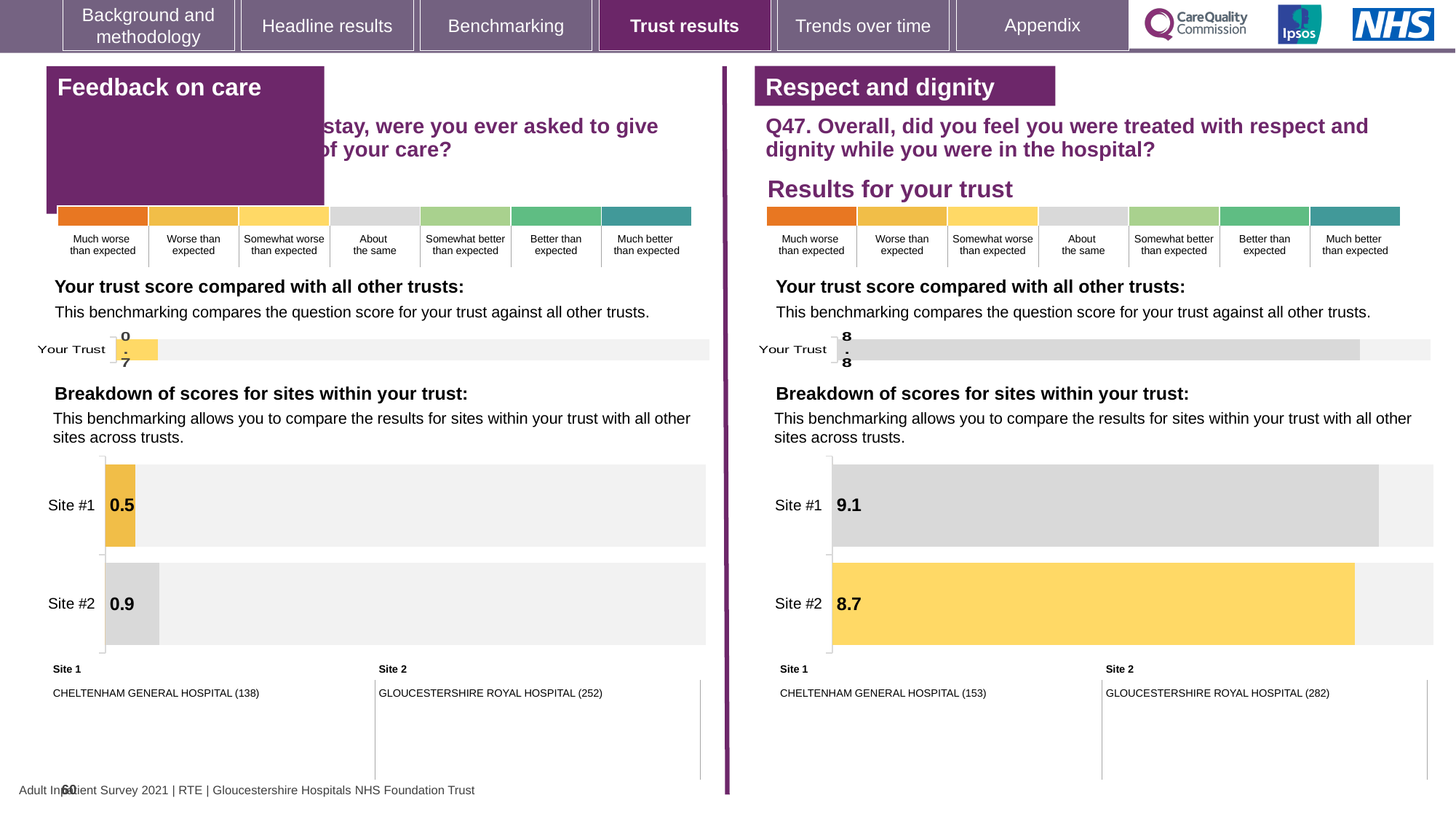
What type of chart is used for the site breakdown under 'Respect and dignity'? Bar chart In the 'Respect and dignity' site breakdown chart, which site has the lower score? Site #2 In the 'Respect and dignity' site breakdown chart, what is the difference between the scores for Site #1 and Site #2? 0.4 In the 'Feedback on care' site breakdown chart, what is the difference between the scores for Site #2 and Site #1? 0.4 In the 'Feedback on care' site breakdown chart, what is the score for Site #1? 0.5 In the 'Respect and dignity' site breakdown chart, what is the score for Site #2? 8.7 In the 'Feedback on care' site breakdown chart, what is the score for Site #2? 0.9 In the 'Feedback on care' site breakdown chart, which site has the higher score? Site #2 In the 'Feedback on care' site breakdown chart, what colour is the bar for Site #1? Yellow In the 'Respect and dignity' site breakdown chart, what is the score for Site #1? 9.1 In the 'Feedback on care' site breakdown chart, how many sites are shown? 2 In the 'Respect and dignity' trust score chart, what is the score for Your Trust? 8.8